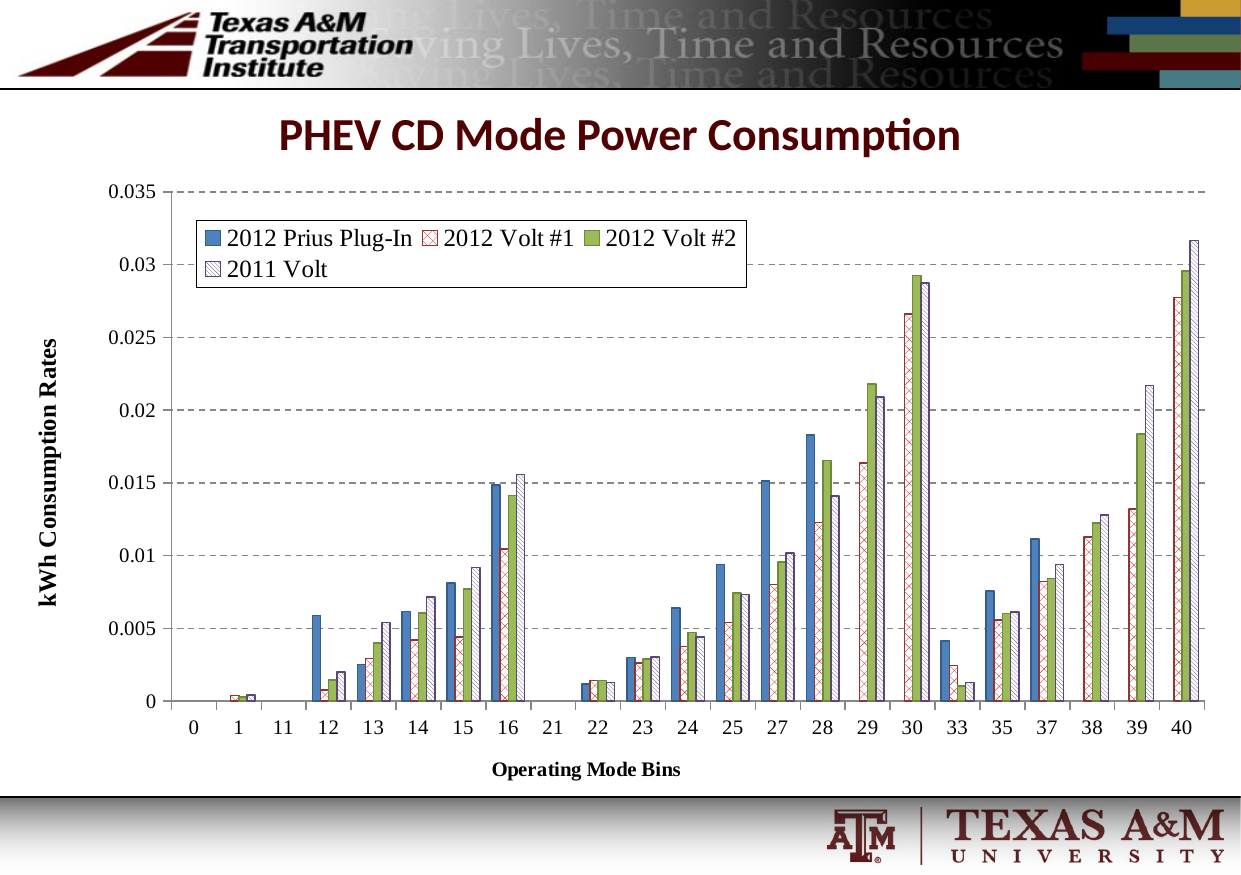
At bin 16, which is larger: the 2011 Volt or the 2012 Volt #1? 2011 Volt How many operating mode bins are shown on the x axis? 23 Is the value for the 2012 Prius Plug-In at bin 33 greater or less than 0.005? less Is the value for the 2011 Volt at bin 40 greater or less than 0.03? greater At bin 28, which is larger: the 2012 Prius Plug-In or the 2012 Volt #1? 2012 Prius Plug-In Which operating mode bin has the highest value for the 2012 Prius Plug-In series? 28 Is the value for the 2012 Volt #2 at bin 30 greater or less than 0.025? greater Which operating mode bin has the highest value for the 2011 Volt series? 40 How many series does the legend list? 4 What is the title of the y axis? kWh Consumption Rates What kind of chart is shown on the slide? bar chart